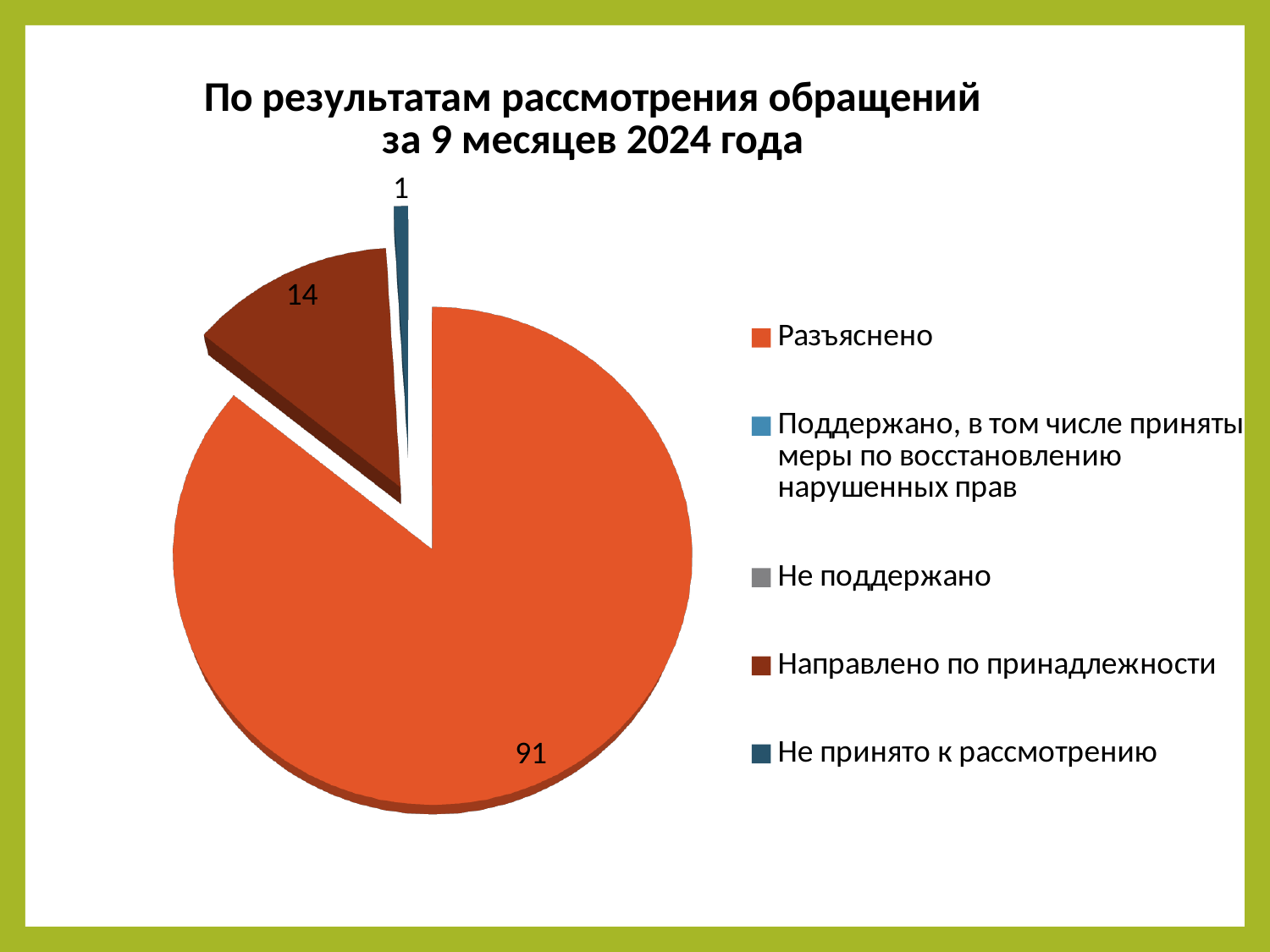
What is the value for Разъяснено? 91 What is the difference between the values for Направлено по принадлежности and Не принято к рассмотрению? 13 How many categories does the legend list? 5 What type of chart is shown on the slide? pie chart Which is larger, the value for Направлено по принадлежности or the value for Не принято к рассмотрению? Направлено по принадлежности What is the value for Не принято к рассмотрению? 1 What is the difference between the values for Разъяснено and Направлено по принадлежности? 77 Which category has the largest slice? Разъяснено What is the value for Направлено по принадлежности? 14 What is the title of the chart? По результатам рассмотрения обращений за 9 месяцев 2024 года What colour is the slice for Разъяснено? orange Which labelled category has the smallest slice? Не принято к рассмотрению